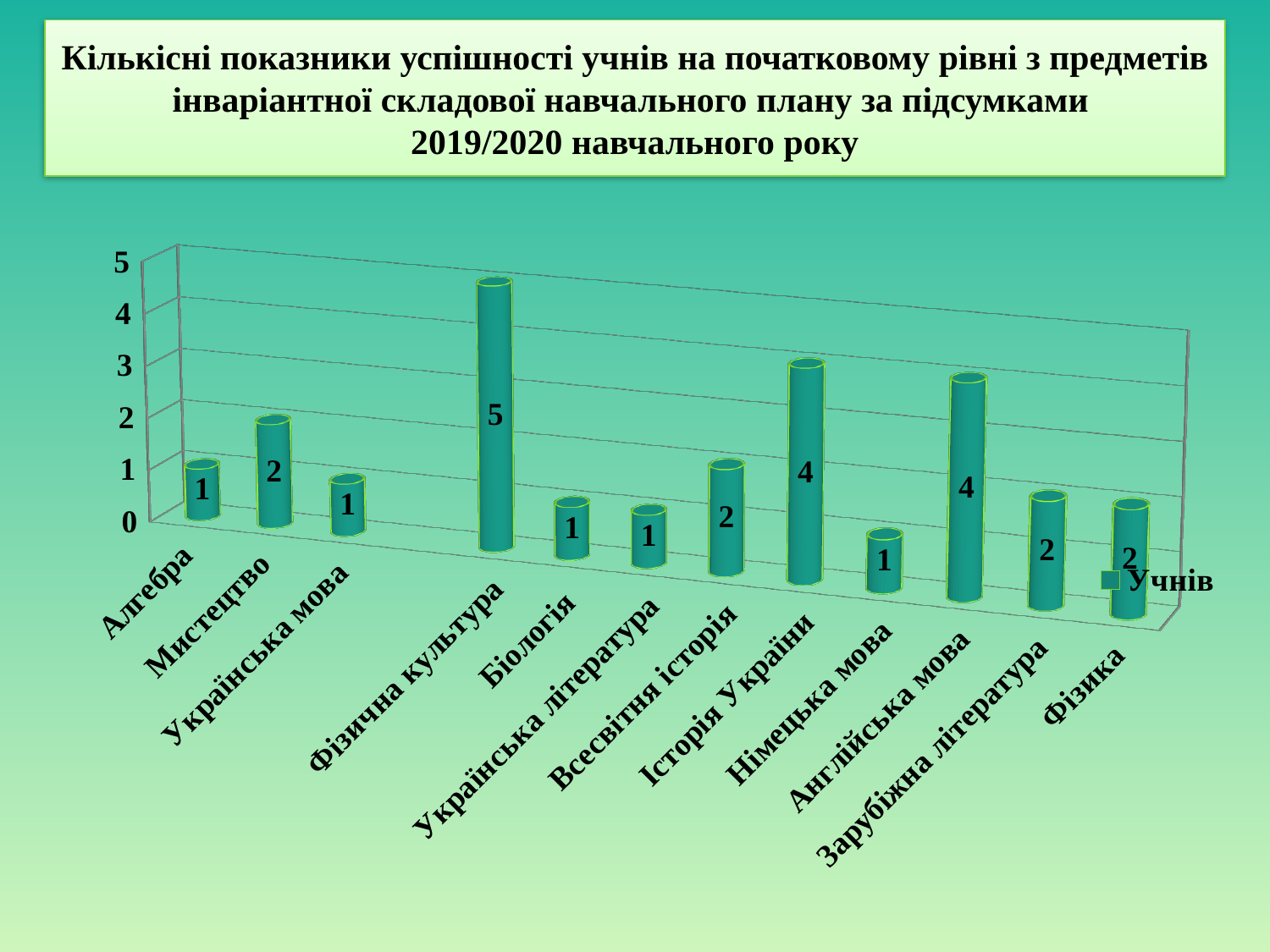
How many categories are shown on the x axis? 12 What value is shown for Історія України? 4 How many series does the legend list? 1 What value is shown for Німецька мова? 1 What value is shown for Фізична культура? 5 What is the name of the series in the legend? Учнів What kind of chart is shown on the slide? Bar chart What value is shown for Мистецтво? 2 Which category has the highest value? Фізична культура What is the difference between the values for Фізична культура and Англійська мова? 1 Which is larger, the value for Зарубіжна література or the value for Біологія? Зарубіжна література What is the difference between the values for Історія України and Всесвітня історія? 2